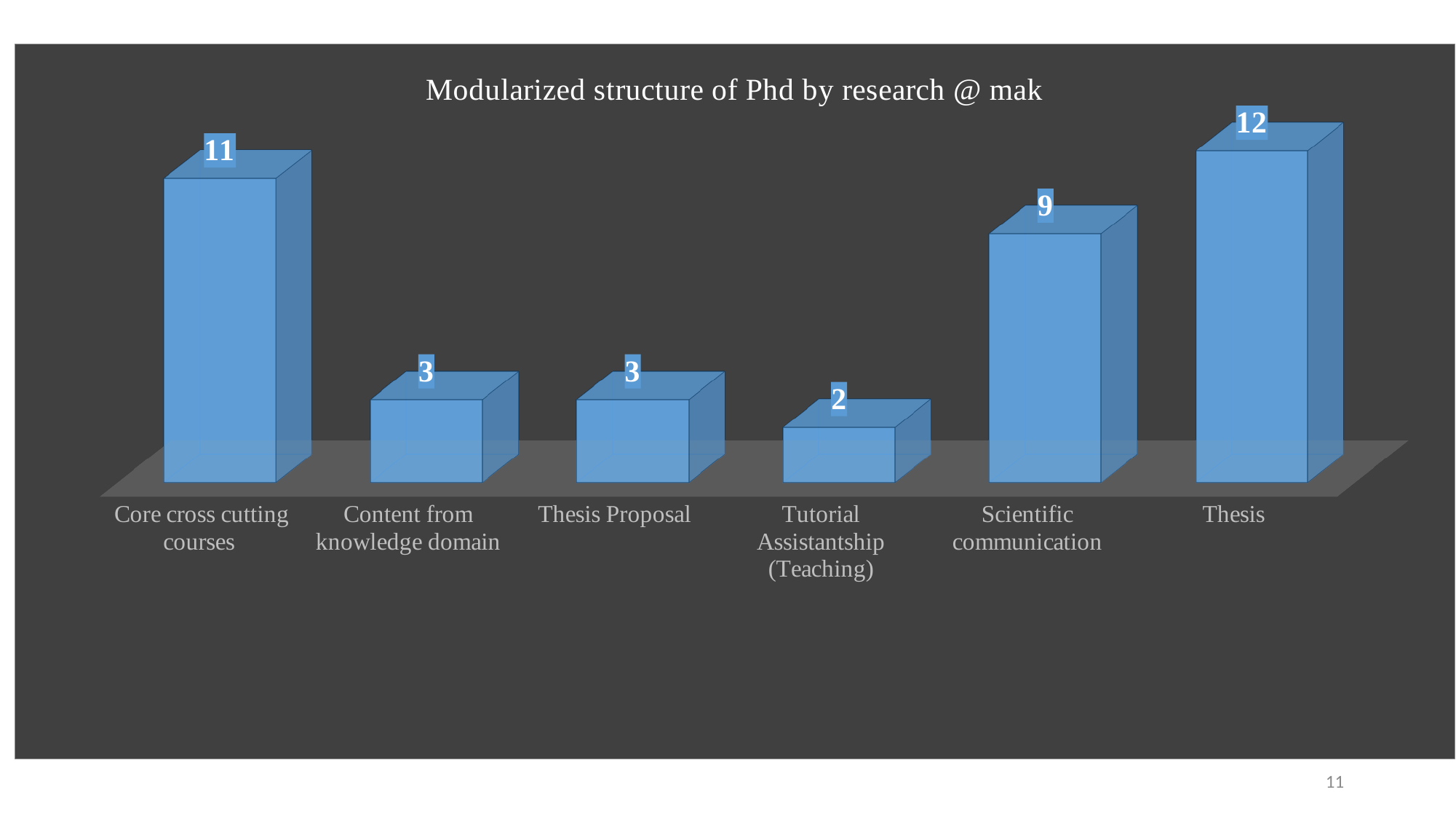
How many categories are shown in the chart? 6 What is the difference between the values for Scientific communication and Content from knowledge domain? 6 Which category has the highest value? Thesis What is the value for Tutorial Assistantship (Teaching)? 2 Which is larger, the value for Core cross cutting courses or the value for Scientific communication? Core cross cutting courses What is the value for Thesis Proposal? 3 What is the title of the chart? Modularized structure of Phd by research @ mak What is the difference between the values for Thesis and Core cross cutting courses? 1 What kind of chart is shown on the slide? Bar chart Which category has the lowest value? Tutorial Assistantship (Teaching) What is the value for Scientific communication? 9 What is the value for Core cross cutting courses? 11